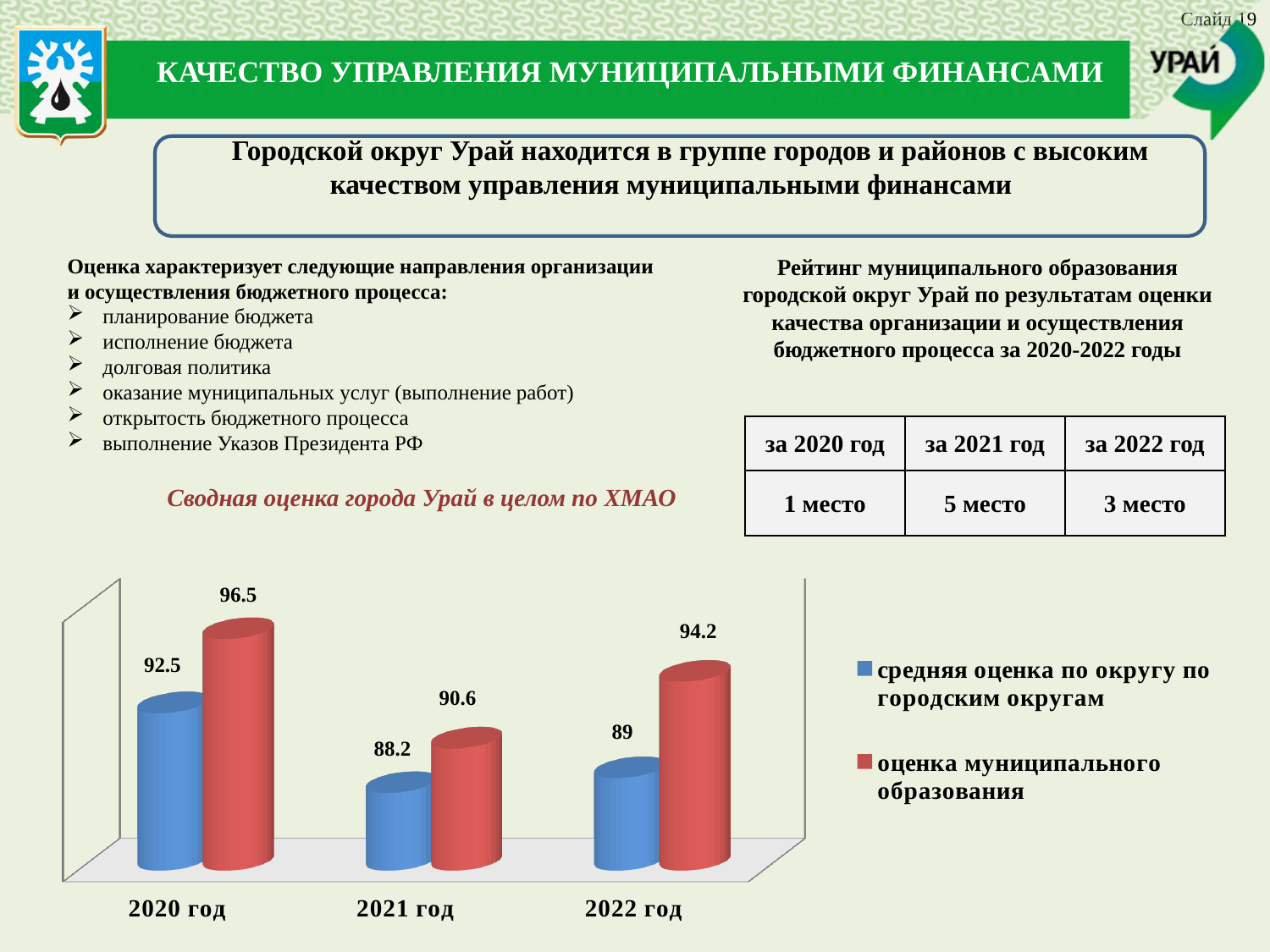
In which year is "оценка муниципального образования" the highest? 2020 год What is the value of "оценка муниципального образования" for 2022 год? 94.2 What is the value of "средняя оценка по округу по городским округам" for 2021 год? 88.2 What is the value of "оценка муниципального образования" for 2020 год? 96.5 How many years are shown on the x axis of the chart? 3 In which year is "средняя оценка по округу по городским округам" the lowest? 2021 год Which colour represents "оценка муниципального образования" in the chart? red What is the difference between "оценка муниципального образования" and "средняя оценка по округу по городским округам" in 2022 год? 5.2 Which is larger in 2020 год: "средняя оценка по округу по городским округам" or "оценка муниципального образования"? оценка муниципального образования What type of chart is shown on the slide? bar chart What is the value of "средняя оценка по округу по городским округам" for 2022 год? 89 How many series does the chart legend list? 2